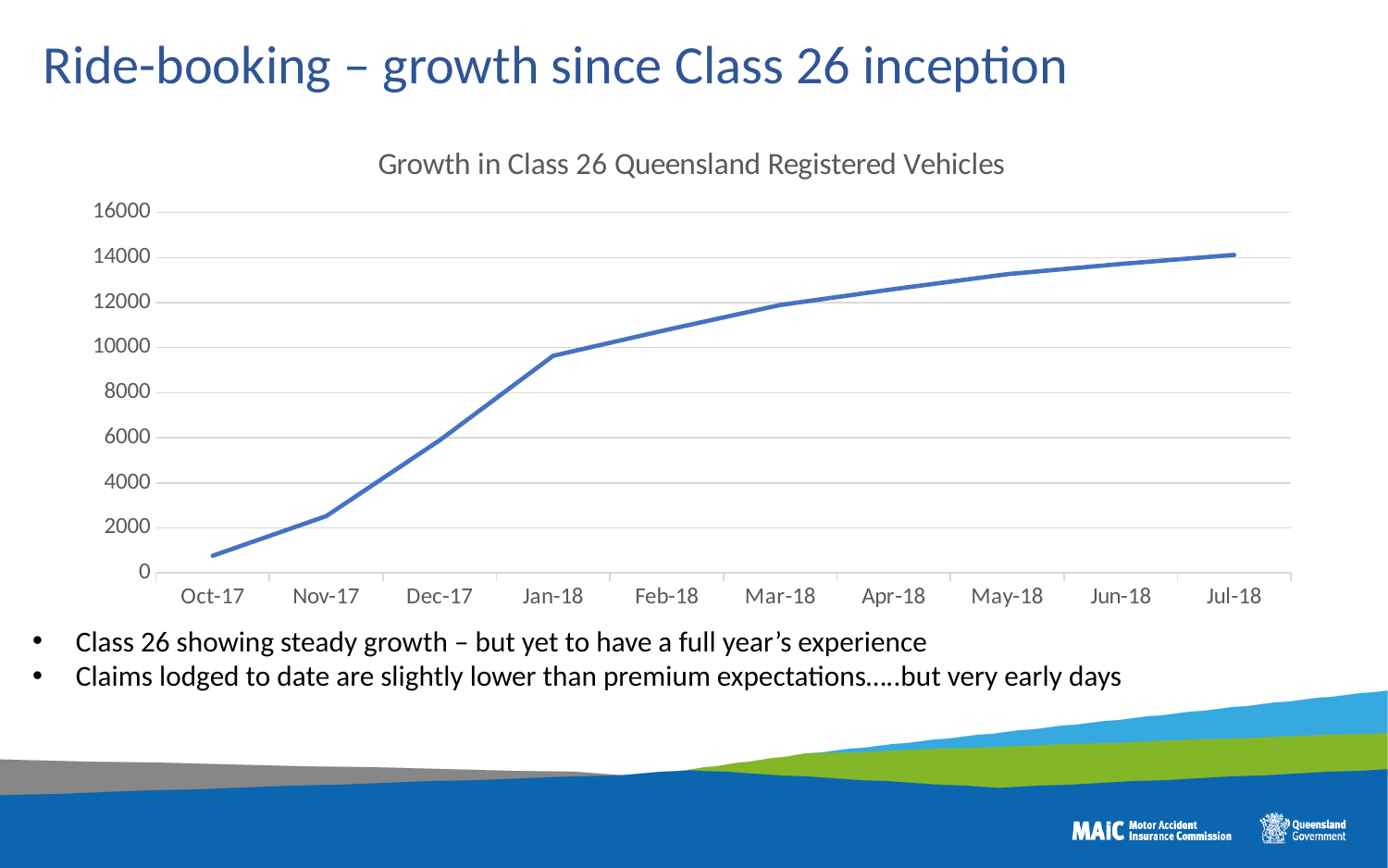
Is the value for Oct-17 greater or less than 2000? less Which month has the lowest value? Oct-17 Is the value for Apr-18 greater or less than 12000? greater What is the title of the chart? Growth in Class 26 Queensland Registered Vehicles Do the values rise or fall from Oct-17 to Jul-18? Rise Which month has the highest value? Jul-18 Which is larger, the value for Jan-18 or the value for Nov-17? Jan-18 Is the value for Nov-17 greater or less than 2000? greater How many months are plotted along the x axis? 10 What kind of chart is shown on the slide? Line chart